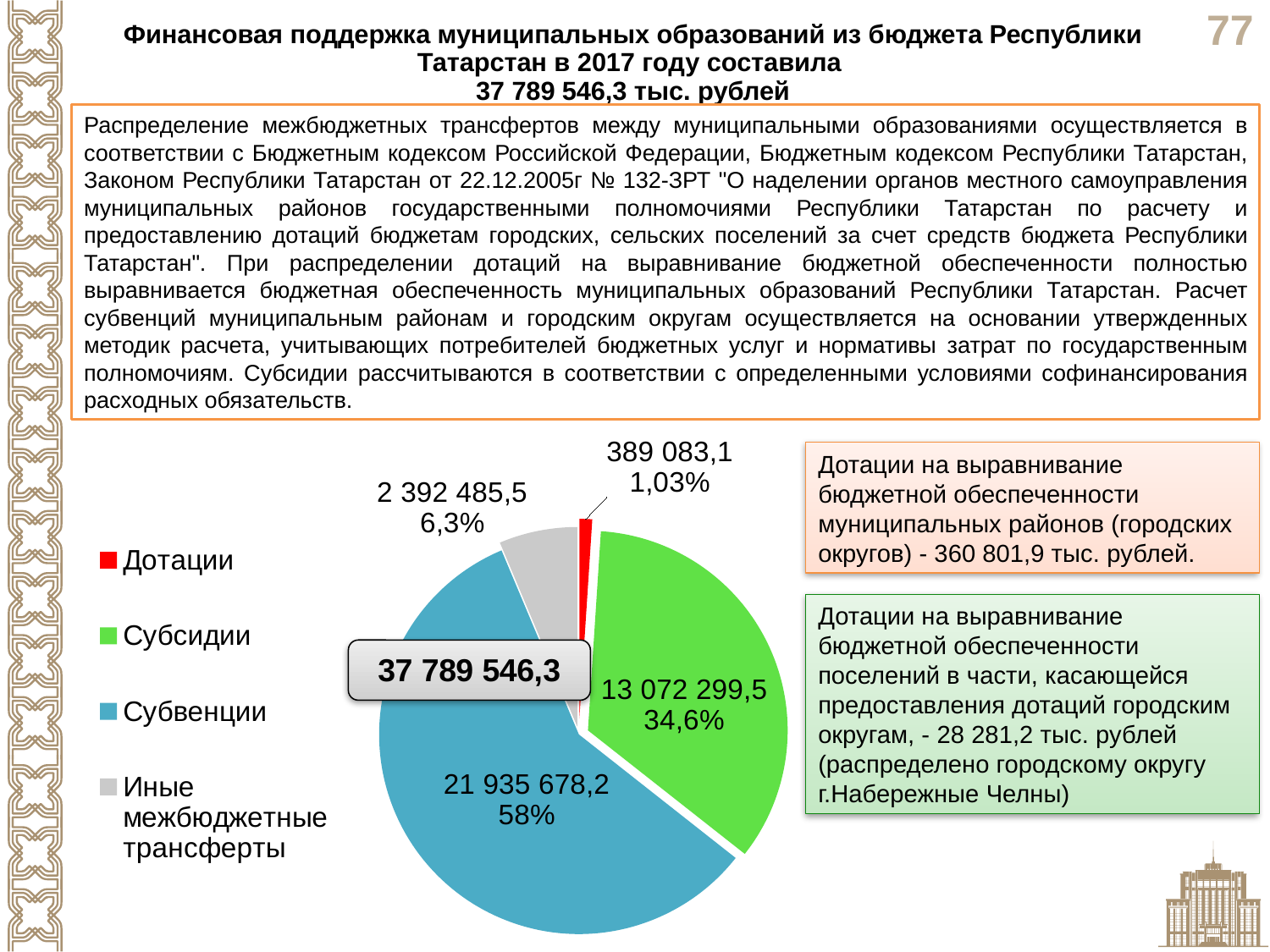
What value is shown for Иные межбюджетные трансферты in the pie chart? 2 392 485,5 Which category has the largest slice in the pie chart? Субвенции Which is larger in the pie chart, Субсидии or Иные межбюджетные трансферты? Субсидии How many entries does the legend of the pie chart list? 4 Which category has the smallest slice in the pie chart? Дотации What kind of chart is shown on the slide? pie chart How many slices does the pie chart have? 4 What value is shown for Дотации in the pie chart? 389 083,1 What share of the pie does Субвенции represent? 58% What share of the pie does Дотации represent? 1,03% What value is shown for Субвенции in the pie chart? 21 935 678,2 What value is shown for Субсидии in the pie chart? 13 072 299,5